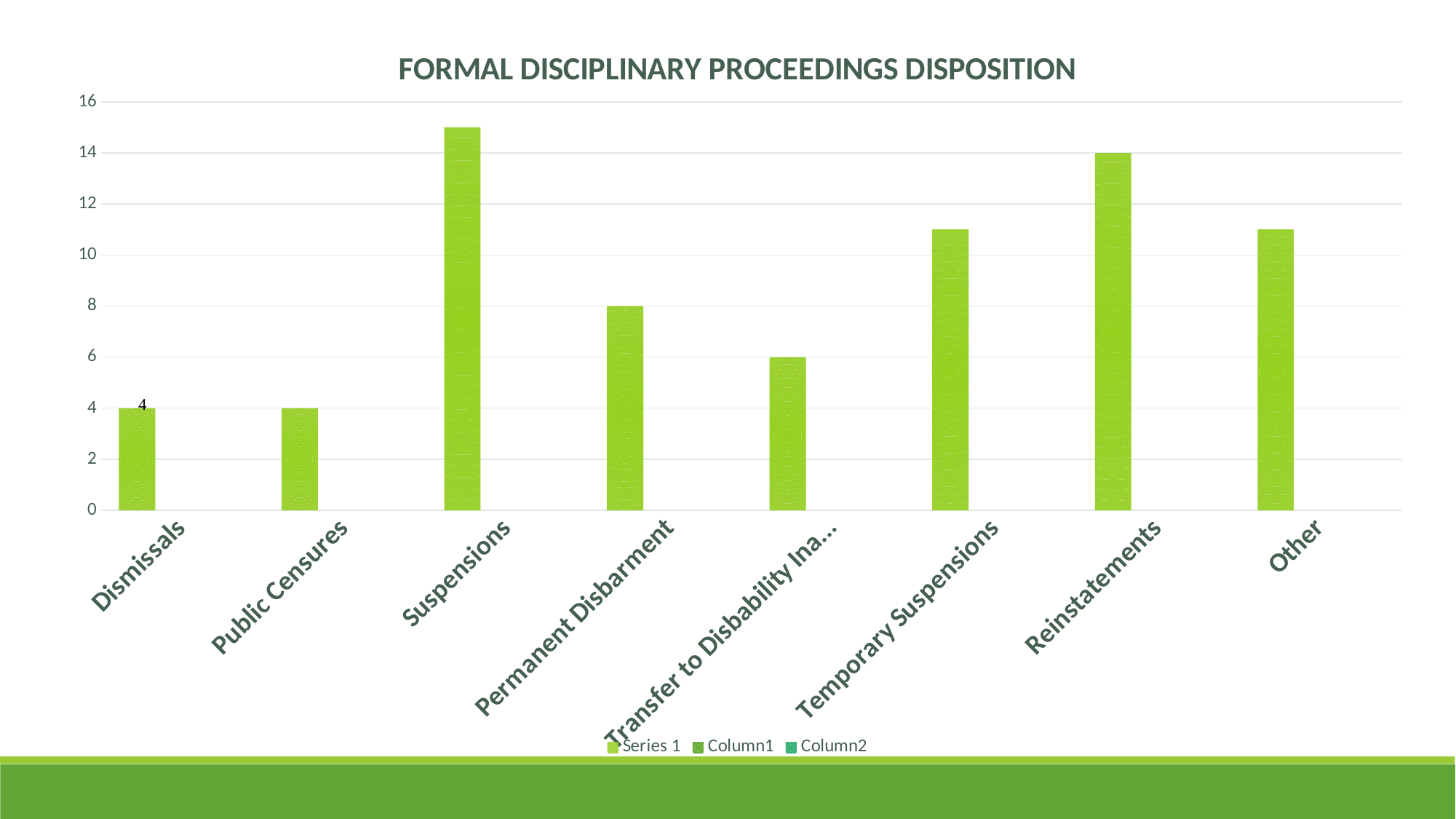
How many categories are shown on the x axis? 8 Is the value for Other greater or less than 10? greater What is the value for Dismissals? 4 Is the value for Suspensions greater or less than 14? greater What is the difference between the values for Reinstatements and Permanent Disbarment? 6 What is the difference between the values for Reinstatements and Dismissals? 10 How many series does the legend list? 3 What is the value for Public Censures? 4 Which is larger, the value for Temporary Suspensions or the value for Permanent Disbarment? Temporary Suspensions What is the value for Reinstatements? 14 Which category has the highest value? Suspensions What is the value for Permanent Disbarment? 8